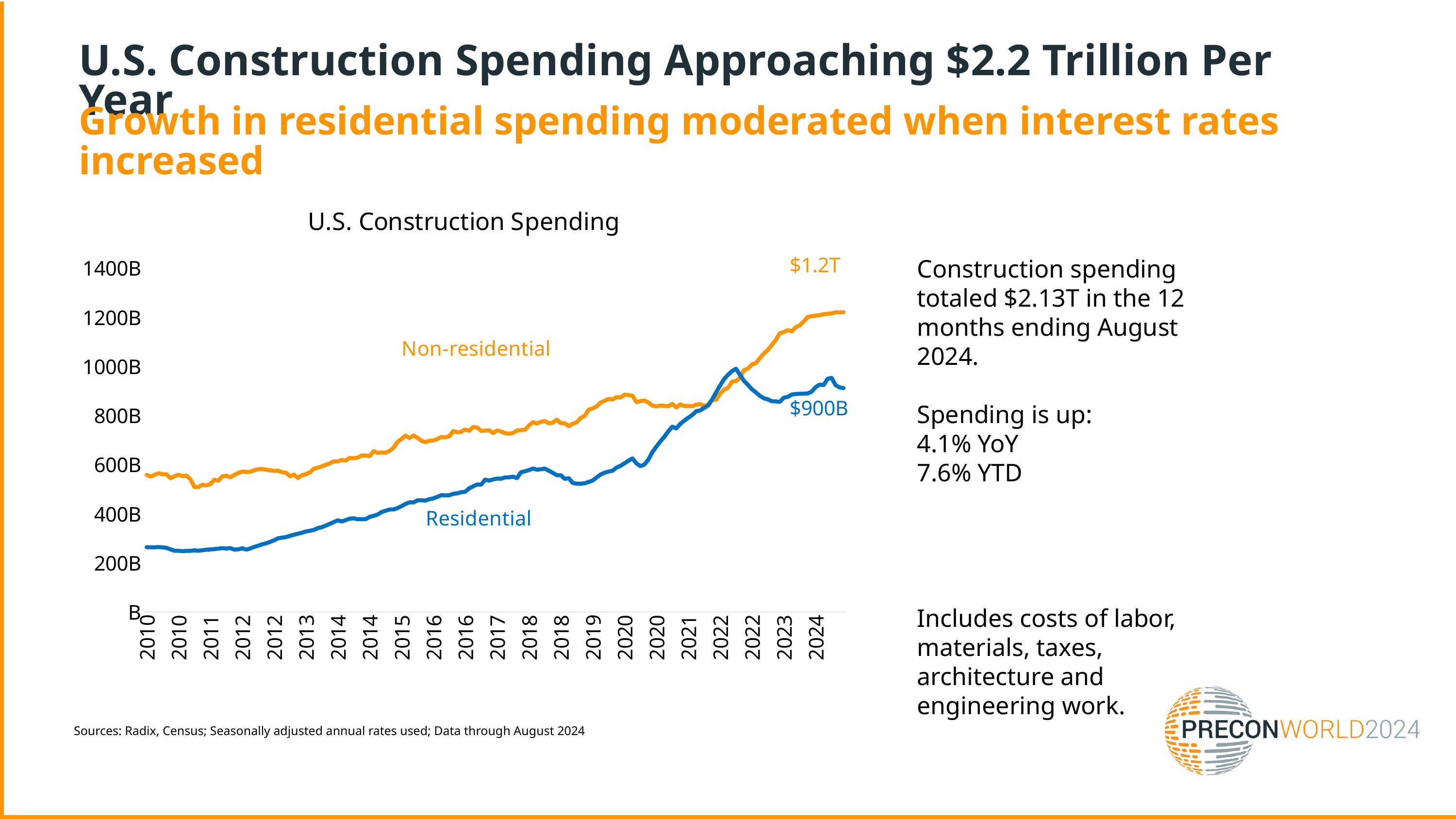
What kind of chart is shown on the slide? line chart Is the Residential value in 2010 greater or less than 400B? less How many series are plotted on the chart? 2 Does the Non-residential series generally rise or fall from 2010 to 2024? rise Is the Residential peak in 2022 greater or less than 1200B? less What is the title of the chart? U.S. Construction Spending Is the Non-residential value in 2010 greater or less than 400B? greater At the end of the chart in 2024, which series is higher, Non-residential or Residential? Non-residential What is the latest labelled value for the Non-residential series? $1.2T What is the latest labelled value for the Residential series? $900B What colour is the Residential line? blue